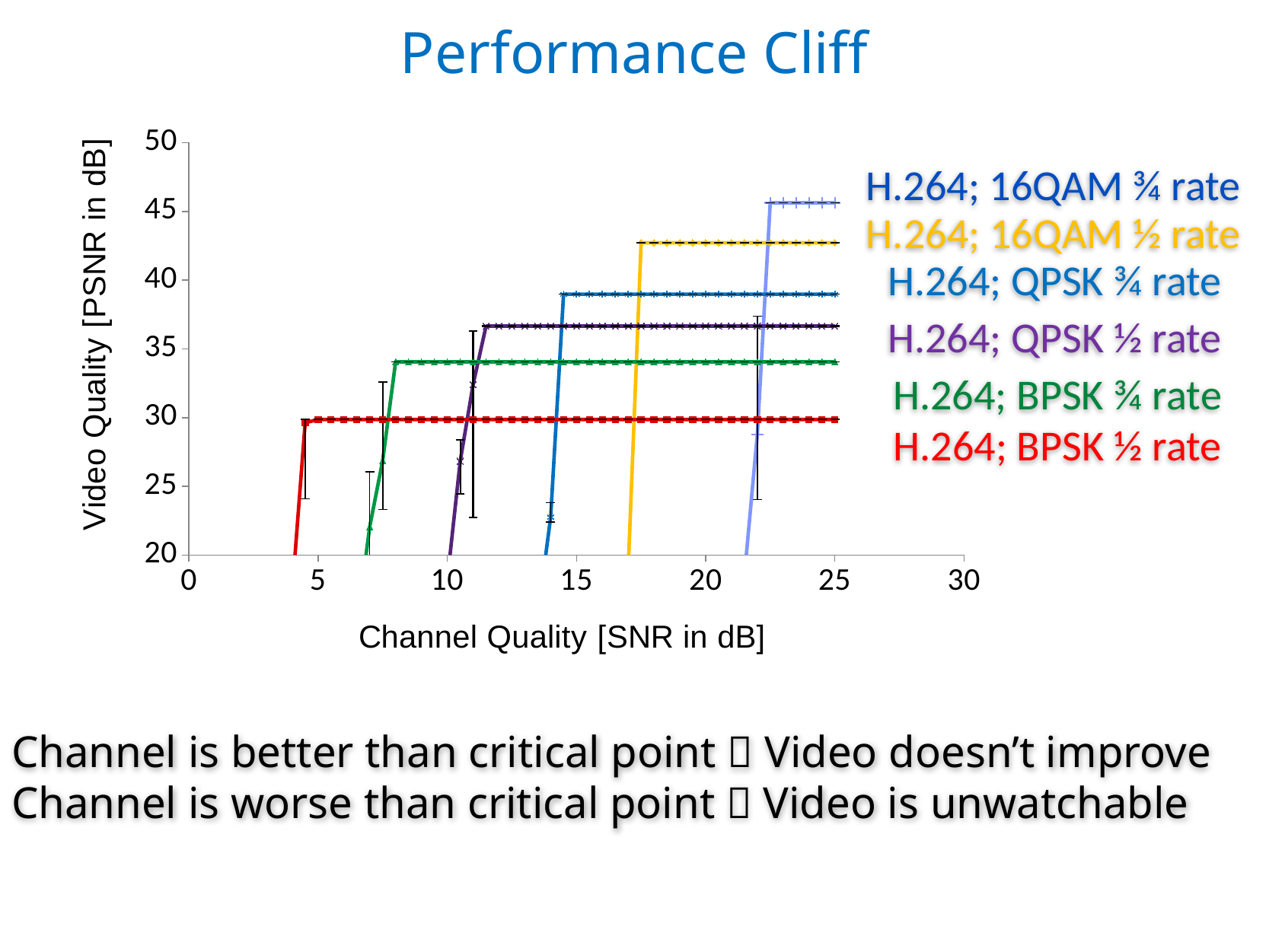
Which series reaches the highest video quality (PSNR) plateau? H.264; 16QAM ¾ rate Which series has the lowest video quality (PSNR) plateau? H.264; BPSK ½ rate Which series reaches its plateau at a lower channel SNR: H.264; BPSK ½ rate or H.264; 16QAM ¾ rate? H.264; BPSK ½ rate Is the plateau PSNR value for H.264; 16QAM ½ rate greater or less than 40? greater How many series does the legend list? 6 Is the plateau PSNR value for H.264; BPSK ½ rate greater or less than 35? less What is the label of the x axis? Channel Quality [SNR in dB] Is the plateau PSNR value for H.264; 16QAM ¾ rate greater or less than 45? greater Which series has a higher plateau PSNR: H.264; QPSK ¾ rate or H.264; BPSK ¾ rate? H.264; QPSK ¾ rate As channel quality (SNR) increases past the critical point, does the video quality for each series rise, fall, or stay flat? stay flat What kind of chart is shown on the slide? line chart What is the title of the chart? Performance Cliff